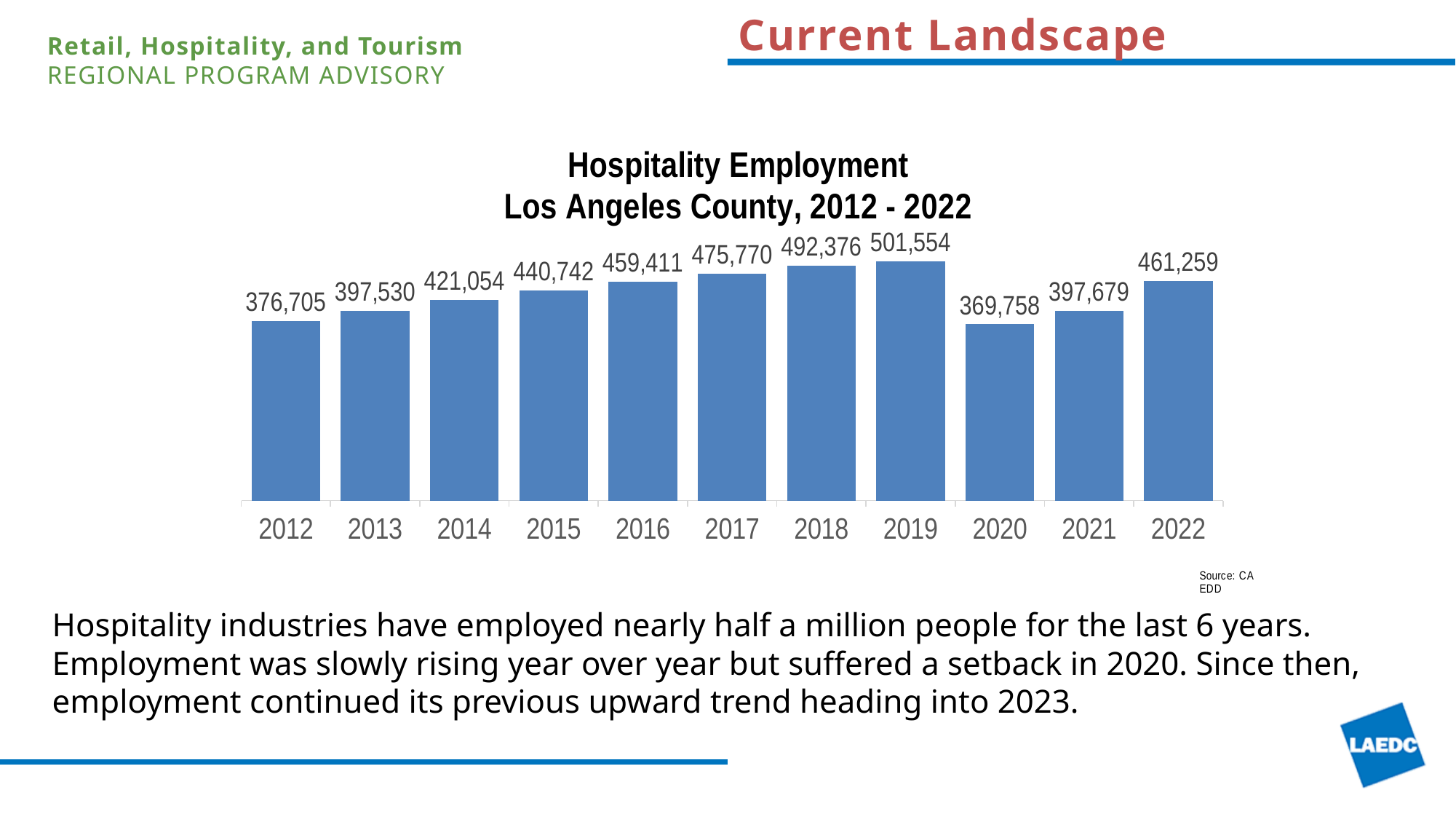
What value is shown for 2022 in the Hospitality Employment chart? 461,259 What was hospitality employment in Los Angeles County in 2019? 501,554 What was hospitality employment in Los Angeles County in 2020? 369,758 What type of chart is used to show hospitality employment in Los Angeles County? Bar chart How many years are shown in the Hospitality Employment chart? 11 Which year has the highest hospitality employment in the chart? 2019 What is the title of the chart on the slide? Hospitality Employment Los Angeles County, 2012 - 2022 What is the difference in hospitality employment between 2022 and 2021? 63,580 Which year has the lowest hospitality employment in the chart? 2020 Did hospitality employment rise or fall from 2012 to 2019? Rise By how much did hospitality employment fall from 2019 to 2020? 131,796 Which year had higher hospitality employment, 2015 or 2022? 2022